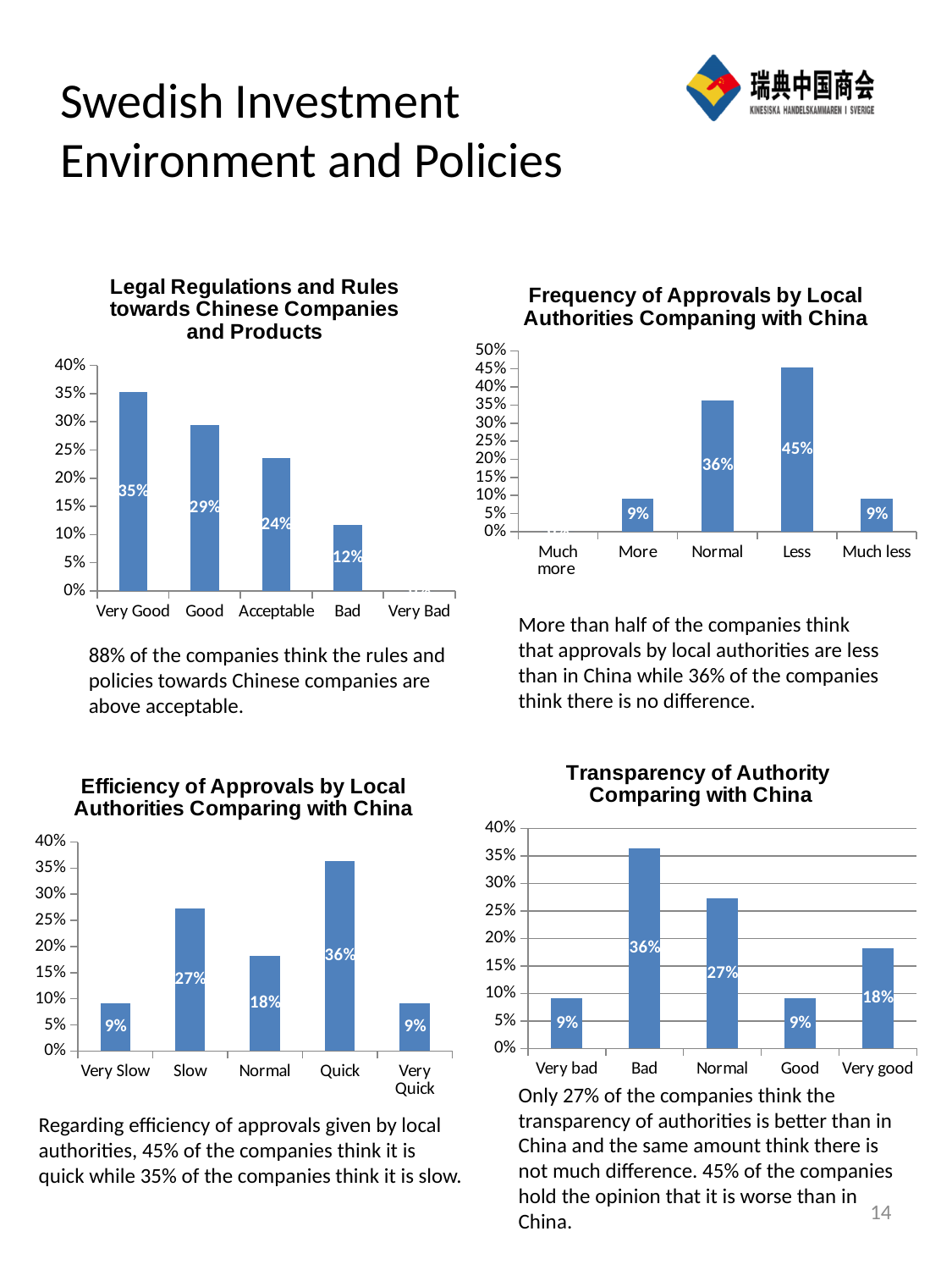
In the 'Legal Regulations and Rules towards Chinese Companies and Products' chart, what is the difference between the Very Good and Bad values? 23% In the 'Transparency of Authority Comparing with China' chart, which category has the highest value? Bad In the 'Legal Regulations and Rules towards Chinese Companies and Products' chart, which category has the highest value? Very Good In the 'Frequency of Approvals by Local Authorities Companing with China' chart, which is larger, Normal or Less? Less In the 'Transparency of Authority Comparing with China' chart, what percentage is shown for Very good? 18% In the 'Legal Regulations and Rules towards Chinese Companies and Products' chart, what percentage is shown for Good? 29% What type of chart is the 'Transparency of Authority Comparing with China' chart? Bar chart In the 'Frequency of Approvals by Local Authorities Companing with China' chart, what percentage is shown for Less? 45% In the 'Frequency of Approvals by Local Authorities Companing with China' chart, how many categories are on the x axis? 5 In the 'Efficiency of Approvals by Local Authorities Comparing with China' chart, what is the difference between the Quick and Normal values? 18% In the 'Efficiency of Approvals by Local Authorities Comparing with China' chart, which category has the highest value? Quick In the 'Efficiency of Approvals by Local Authorities Comparing with China' chart, what percentage is shown for Slow? 27%